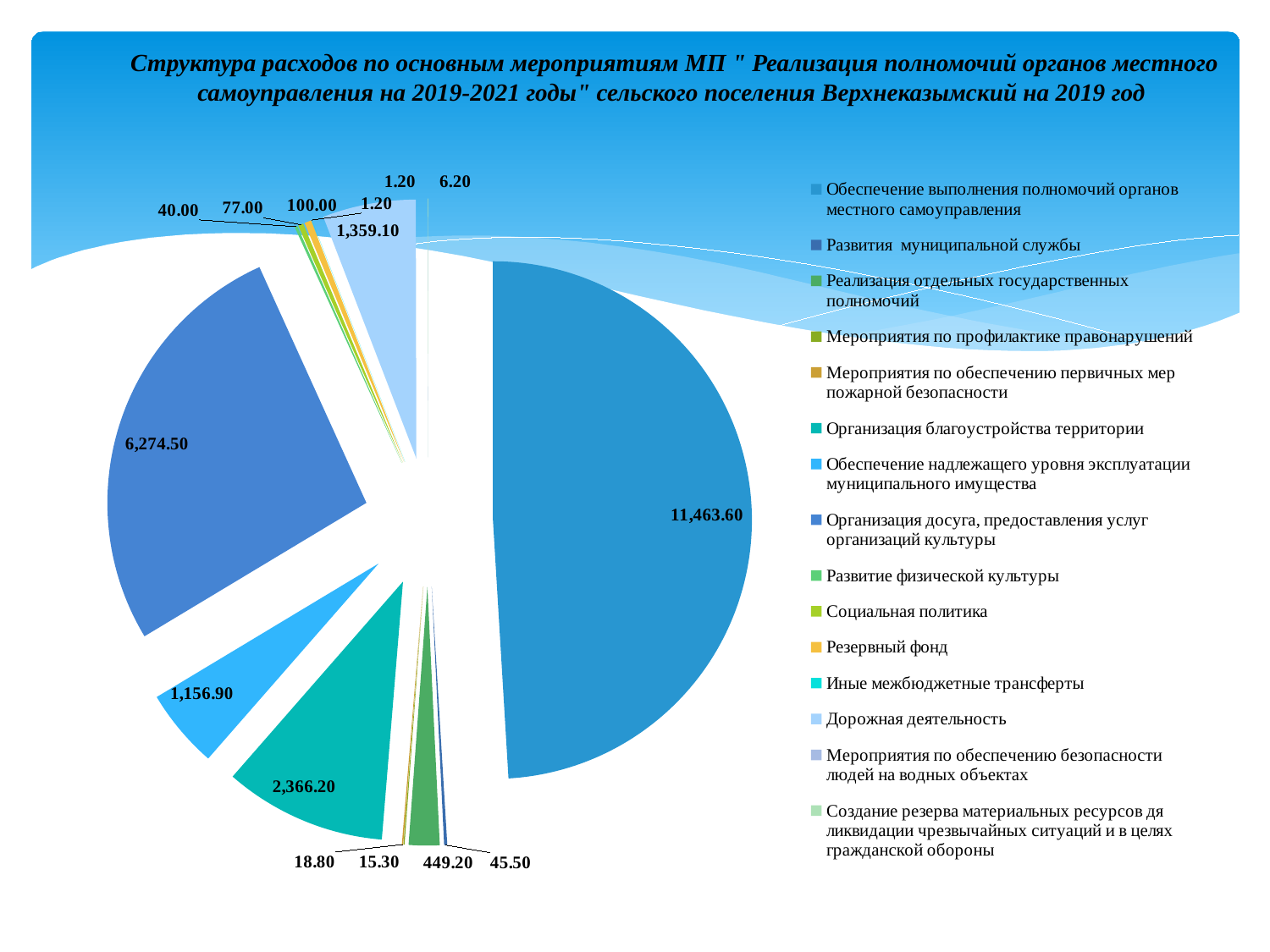
What is the difference between the values for Обеспечение выполнения полномочий органов местного самоуправления and Организация досуга, предоставления услуг организаций культуры? 5,189.10 What is the value shown for Обеспечение надлежащего уровня эксплуатации муниципального имущества? 1,156.90 What is the value shown for Развитие физической культуры? 40.00 How many entries does the legend of the pie chart list? 15 Which is larger: the value for Дорожная деятельность or the value for Обеспечение надлежащего уровня эксплуатации муниципального имущества? Дорожная деятельность What is the value shown for Дорожная деятельность? 1,359.10 What is the value shown for Организация благоустройства территории? 2,366.20 What is the value shown for Организация досуга, предоставления услуг организаций культуры? 6,274.50 What type of chart is shown on the slide? pie chart What is the smallest value labelled on the pie chart? 1.20 What is the value of the largest slice in the pie chart? 11,463.60 Which category does the largest slice of the pie chart represent? Обеспечение выполнения полномочий органов местного самоуправления